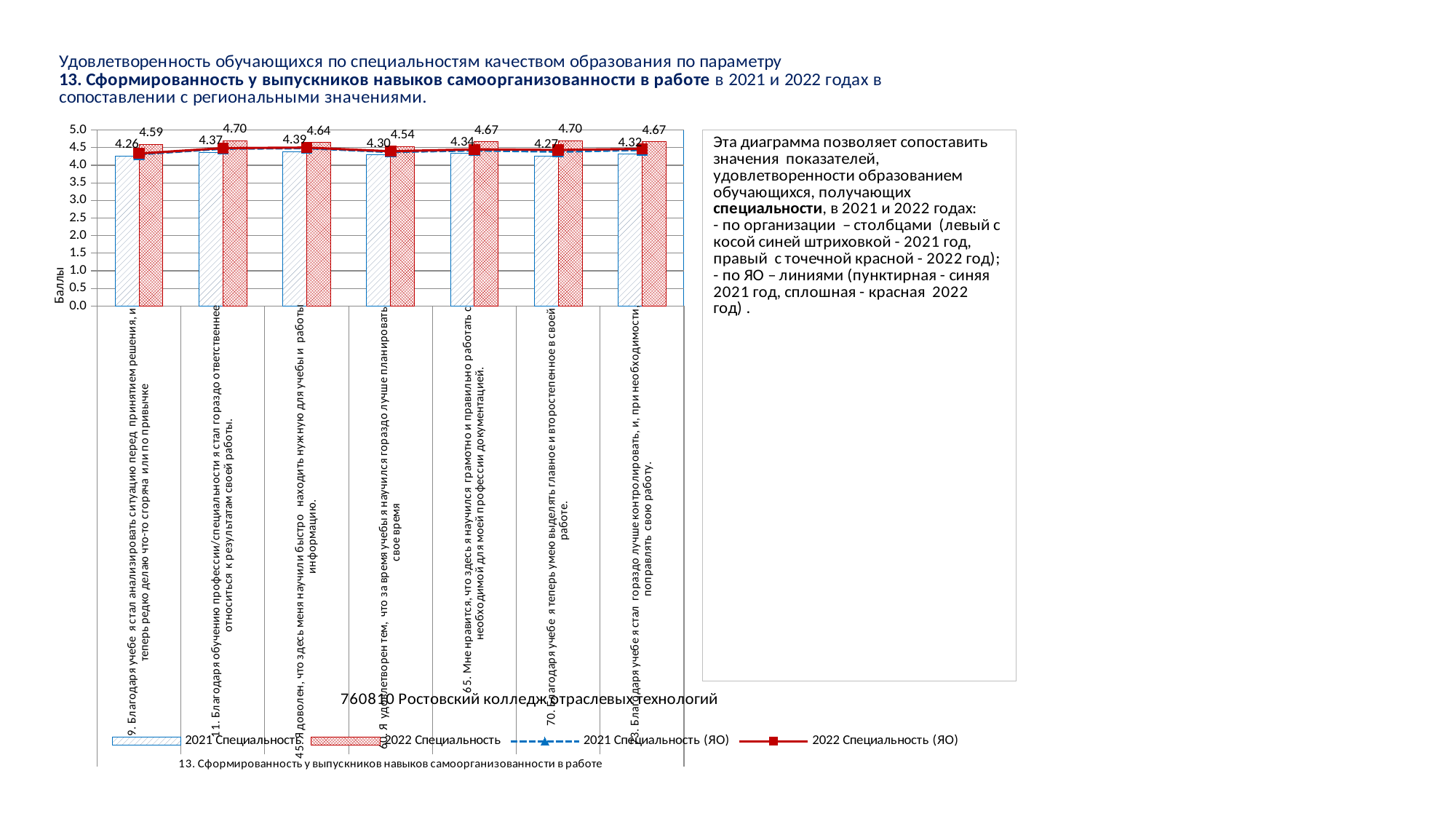
For category 9, which is larger: the 2021 Специальность value or the 2022 Специальность value? 2022 Специальность (4.59) What kind of chart is shown on the slide? Bar chart with line series Which category has the highest 2021 Специальность value? 45. Я доволен, что здесь меня научили быстро находить нужную для учебы и работы информацию (4.39) Which category has the lowest 2021 Специальность value? 9. Благодаря учебе я стал анализировать ситуацию перед принятием решения (4.26) What is the value of the 2021 Специальность bar for category 70 (Благодаря учебе я теперь умею выделять главное и второстепенное в своей работе)? 4.27 How many categories (questions) are shown on the x axis of the chart? 7 What is the value of the 2022 Специальность bar for category 65 (Мне нравится, что здесь я научился грамотно и правильно работать с документацией)? 4.67 What is the lowest 2022 Специальность value shown on the chart? 4.54 What is the value of the 2022 Специальность bar for category 11 (Благодаря обучению профессии/специальности я стал гораздо ответственнее относиться к результатам своей работы)? 4.70 What is the value of the 2021 Специальность bar for category 9 (Благодаря учебе я стал анализировать ситуацию перед принятием решения)? 4.26 What is the difference between the 2022 and 2021 Специальность values for category 45? 0.25 How many series does the chart legend list? 4